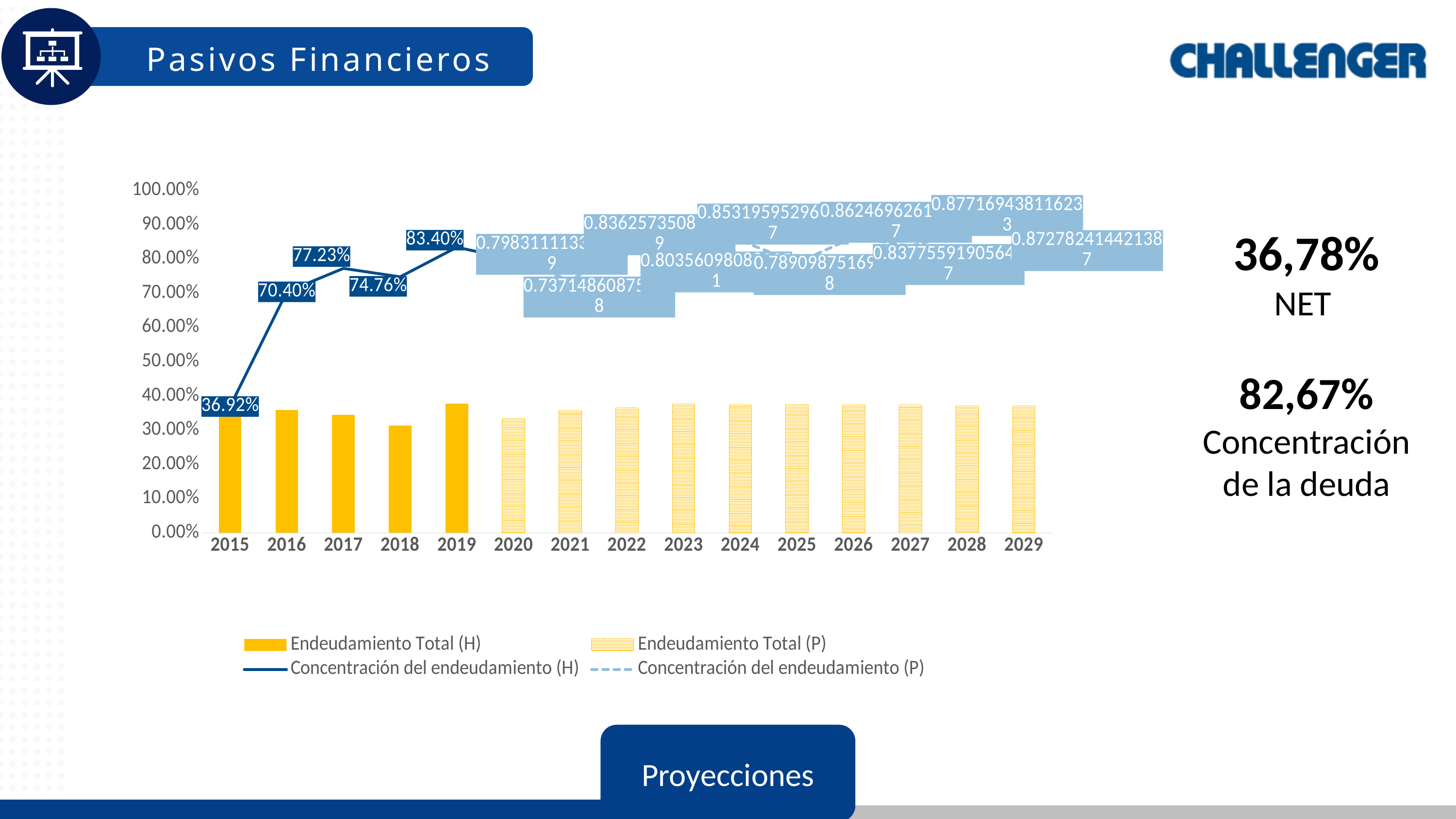
In which year is the labelled Concentración del endeudamiento (H) value highest? 2019 In which year is the labelled Concentración del endeudamiento (H) value lowest? 2015 How many series does the chart legend list? 4 How many years are shown on the x axis of the chart? 15 What is the difference between the Concentración del endeudamiento (H) values for 2016 and 2015? 33.48 percentage points What is the value of Concentración del endeudamiento (H) for 2015? 36.92% What is the value of Concentración del endeudamiento (H) for 2017? 77.23% What kind of chart is shown on the slide? Combination bar and line chart Is the Endeudamiento Total (H) bar for 2019 greater or less than 30.00%? greater What is the value of Concentración del endeudamiento (H) for 2019? 83.40% Which year has the larger Concentración del endeudamiento (H) value, 2017 or 2018? 2017